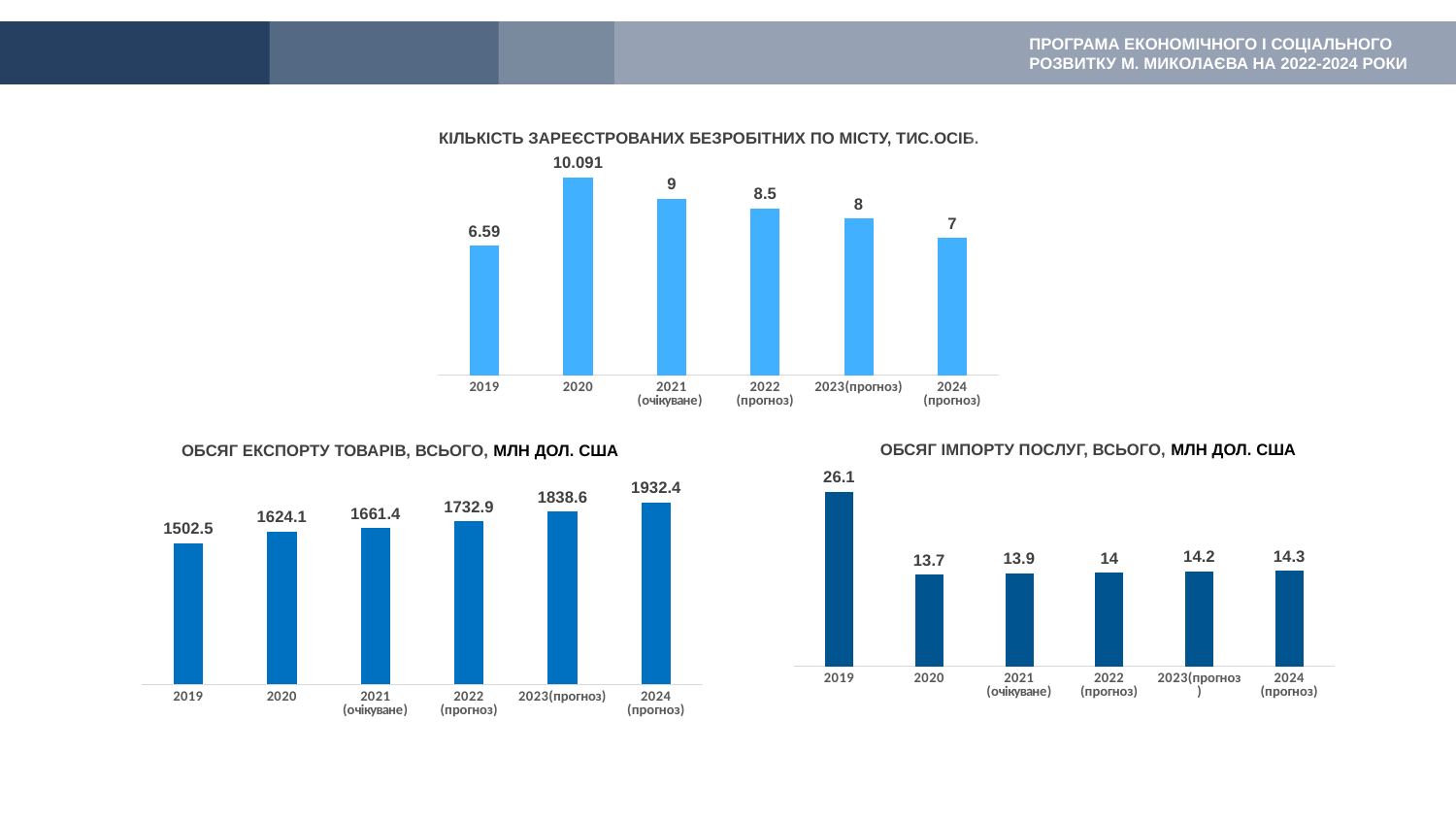
What unit is stated in the title of the bottom-right chart (ОБСЯГ ІМПОРТУ ПОСЛУГ)? МЛН ДОЛ. США In the top chart (КІЛЬКІСТЬ ЗАРЕЄСТРОВАНИХ БЕЗРОБІТНИХ ПО МІСТУ), what is the difference between the 2020 value and the 2024 (прогноз) value? 3.091 In the bottom-left chart (ОБСЯГ ЕКСПОРТУ ТОВАРІВ), what is the difference between the 2024 (прогноз) value and the 2019 value? 429.9 In the bottom-right chart (ОБСЯГ ІМПОРТУ ПОСЛУГ), what is the value for 2019? 26.1 In the top chart (КІЛЬКІСТЬ ЗАРЕЄСТРОВАНИХ БЕЗРОБІТНИХ ПО МІСТУ), what is the value for 2020? 10.091 In the bottom-left chart (ОБСЯГ ЕКСПОРТУ ТОВАРІВ), which year has the highest value? 2024 (прогноз) In the top chart (КІЛЬКІСТЬ ЗАРЕЄСТРОВАНИХ БЕЗРОБІТНИХ ПО МІСТУ), which year has the lowest value? 2019 In the top chart (КІЛЬКІСТЬ ЗАРЕЄСТРОВАНИХ БЕЗРОБІТНИХ ПО МІСТУ), how many bars are plotted? 6 In the bottom-right chart (ОБСЯГ ІМПОРТУ ПОСЛУГ), which is larger, the value for 2019 or the value for 2020? 2019 In the bottom-left chart (ОБСЯГ ЕКСПОРТУ ТОВАРІВ), what is the value for 2022 (прогноз)? 1732.9 What kind of chart is the bottom-right chart (ОБСЯГ ІМПОРТУ ПОСЛУГ)? bar chart In the bottom-left chart (ОБСЯГ ЕКСПОРТУ ТОВАРІВ), do the values rise or fall from 2019 to 2024? rise